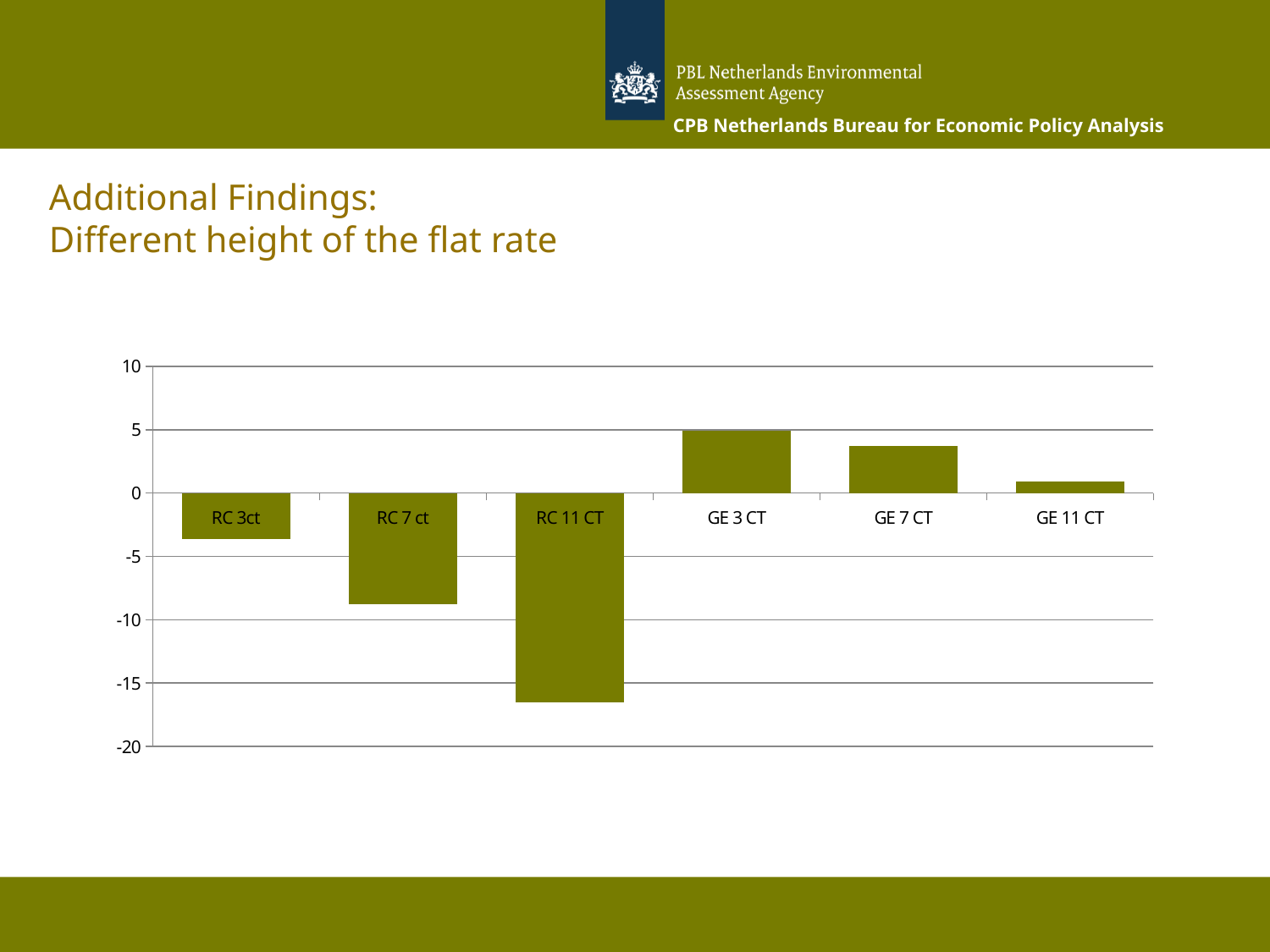
Which category has the lowest value in the chart? RC 11 CT Is the value for GE 11 CT greater or less than 0? greater Which is larger, the value for RC 3ct or the value for RC 7 ct? RC 3ct What kind of chart is shown on the slide? bar chart Which category has the highest value in the chart? GE 3 CT Is the value for RC 7 ct greater or less than -5? less Is the value for GE 7 CT greater or less than 5? less Which is larger, the value for GE 3 CT or the value for GE 11 CT? GE 3 CT Across the three RC categories (RC 3ct, RC 7 ct, RC 11 CT), do the values rise or fall from left to right? fall How many categories are plotted in the chart? 6